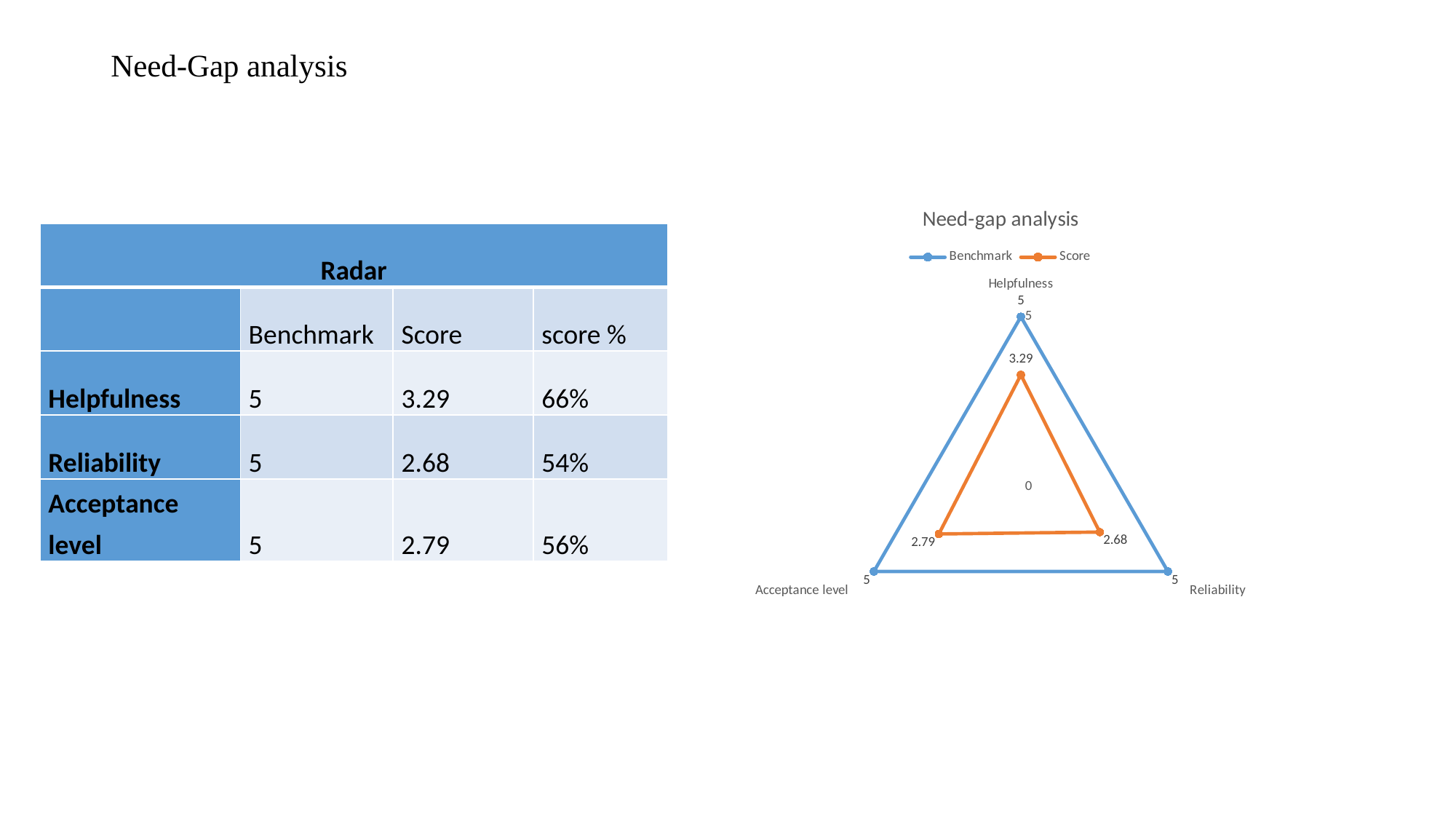
What kind of chart is shown on the slide? radar chart Which category has the lowest Score value? Reliability How many series does the legend list? 2 What is the difference between the Benchmark and Score values for Helpfulness? 1.71 Which series is drawn in orange? Score What is the chart's title? Need-gap analysis How many categories (axes) does the radar chart have? 3 What is the Benchmark value for Reliability? 5 What is the Score value for Reliability? 2.68 What is the Score value for Helpfulness? 3.29 Which category has the highest Score value? Helpfulness What is the Score value for Acceptance level? 2.79